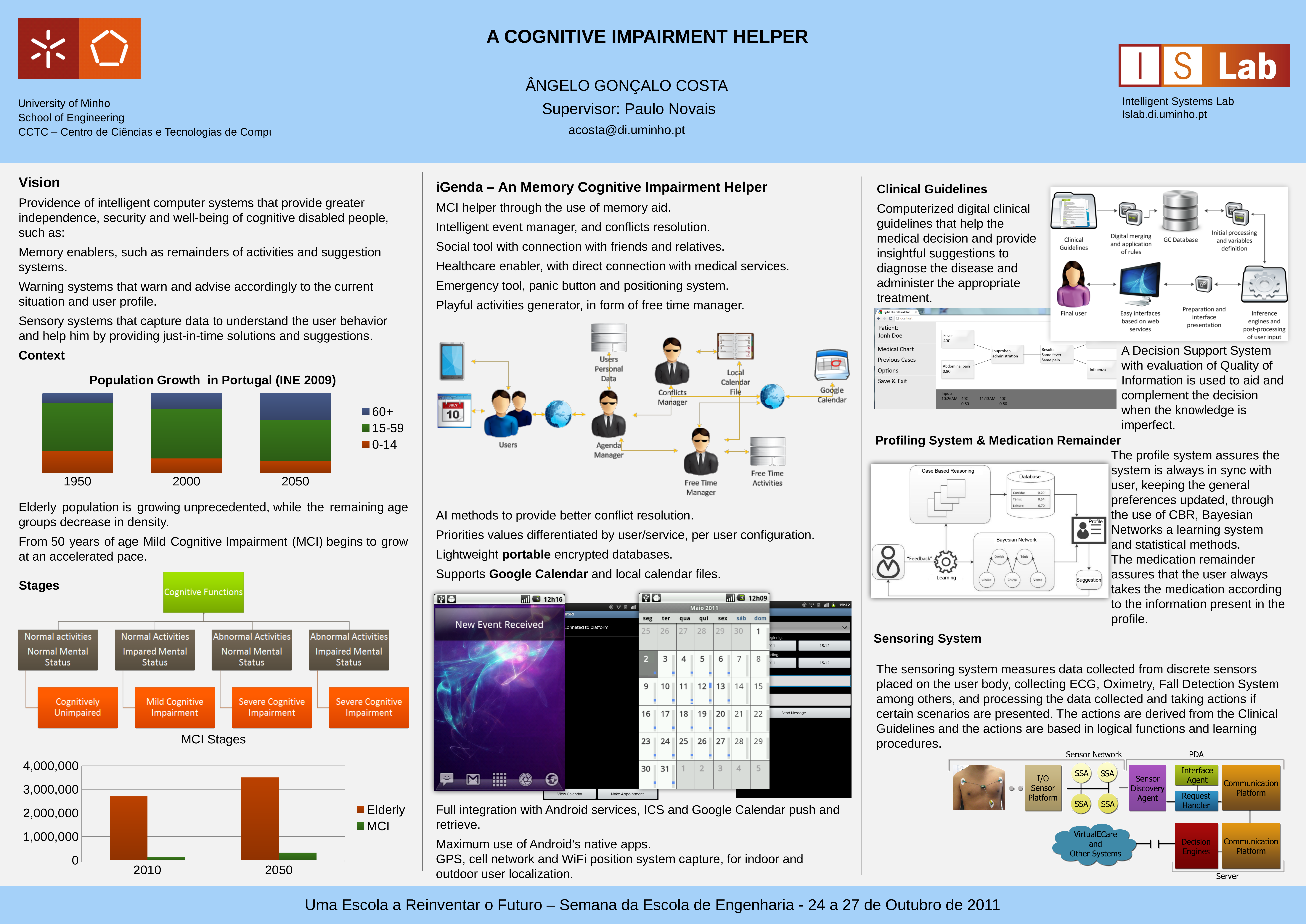
How many years are shown on the x axis of the 'Population Growth in Portugal (INE 2009)' chart? 3 In the bottom-left Elderly/MCI chart, is the MCI value for 2010 greater or less than 1,000,000? less In the bottom-left Elderly/MCI chart, is the Elderly value larger in 2010 or in 2050? 2050 In the bottom-left Elderly/MCI chart, is the Elderly value for 2050 greater or less than 3,000,000? greater How many series does the legend of the bottom-left Elderly/MCI chart list? 2 What kind of chart is the bottom-left chart with the Elderly and MCI series? bar chart In the 'Population Growth in Portugal (INE 2009)' chart, does the 60+ segment rise or fall from 1950 to 2050? rise In the 'Population Growth in Portugal (INE 2009)' chart, which age group is shown in green? 15-59 What kind of chart is the 'Population Growth in Portugal (INE 2009)' chart? stacked bar chart How many series does the legend of the 'Population Growth in Portugal (INE 2009)' chart list? 3 In the 'Population Growth in Portugal (INE 2009)' chart, is the 0-14 segment larger in 1950 or in 2050? 1950 In the bottom-left Elderly/MCI chart, which bar is the highest? Elderly in 2050